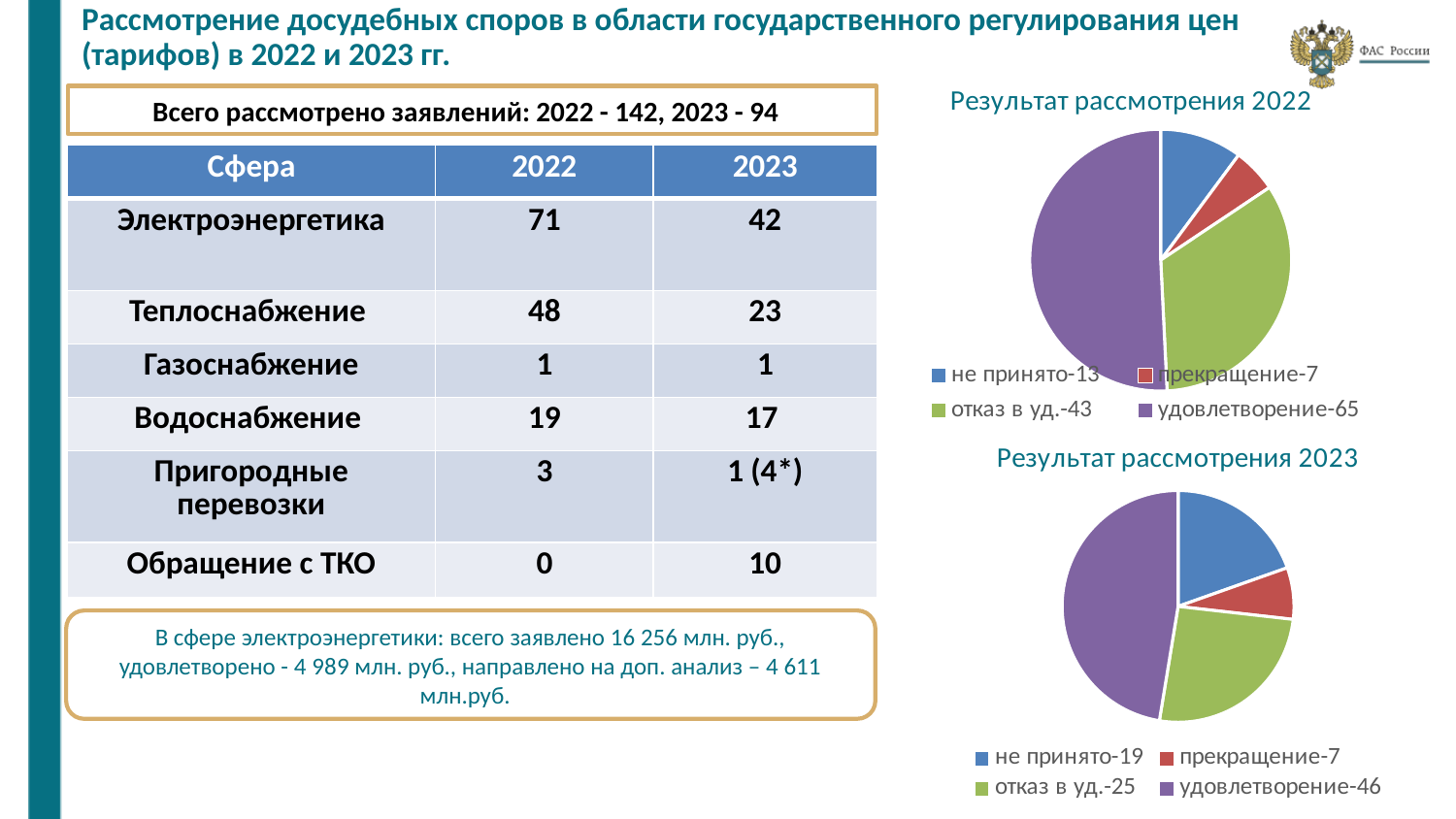
In the pie chart 'Результат рассмотрения 2022', what is the difference between 'удовлетворение' and 'отказ в уд.'? 22 In the pie chart 'Результат рассмотрения 2022', what is the value for 'не принято'? 13 In the pie chart 'Результат рассмотрения 2023', what is the difference between 'удовлетворение' and 'не принято'? 27 How many categories does the legend of the pie chart 'Результат рассмотрения 2022' list? 4 In the pie chart 'Результат рассмотрения 2023', what is the value for 'отказ в уд.'? 25 What type of chart is 'Результат рассмотрения 2023'? pie chart In the pie chart 'Результат рассмотрения 2022', which category has the largest slice? удовлетворение In the pie chart 'Результат рассмотрения 2022', what colour is the 'удовлетворение' slice? purple In the pie chart 'Результат рассмотрения 2023', which is larger: 'не принято' or 'отказ в уд.'? отказ в уд. In the pie chart 'Результат рассмотрения 2023', which category has the smallest slice? прекращение In the pie chart 'Результат рассмотрения 2023', what is the value for 'прекращение'? 7 In the pie chart 'Результат рассмотрения 2022', what is the value for 'удовлетворение'? 65